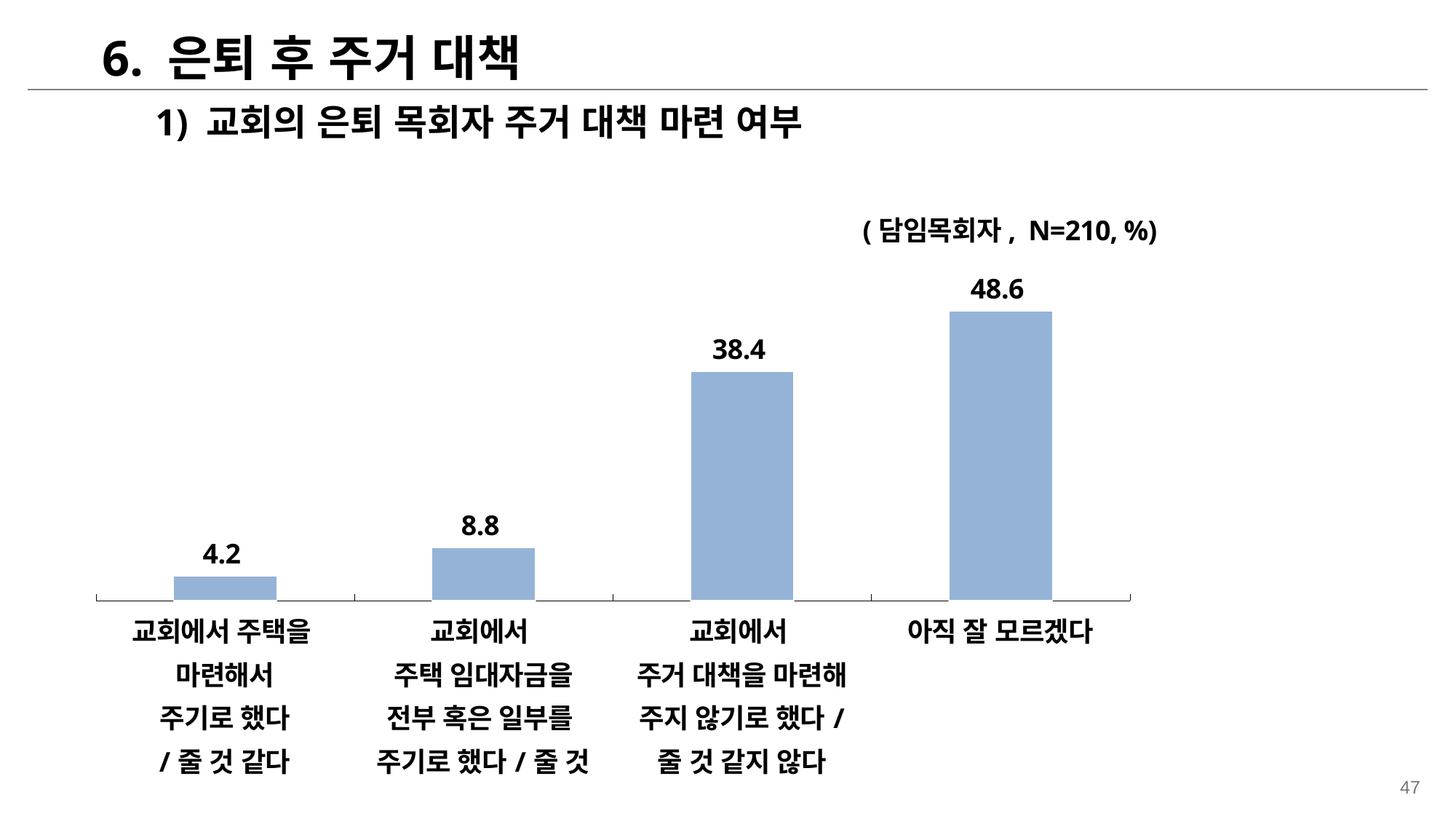
Which category has the lowest value? 교회에서 주택을 마련해서 주기로 했다 / 줄 것 같다 What is the value for '교회에서 주거 대책을 마련해 주지 않기로 했다 / 줄 것 같지 않다'? 38.4 What is the value for '교회에서 주택을 마련해서 주기로 했다 / 줄 것 같다'? 4.2 What kind of chart is shown on the slide? Bar chart Which is larger: the value for '교회에서 주거 대책을 마련해 주지 않기로 했다 / 줄 것 같지 않다' or the value for '교회에서 주택 임대자금을 전부 혹은 일부를 주기로 했다 / 줄 것'? 교회에서 주거 대책을 마련해 주지 않기로 했다 / 줄 것 같지 않다 What is the difference between the values for '교회에서 주택 임대자금을 전부 혹은 일부를 주기로 했다 / 줄 것' and '교회에서 주택을 마련해서 주기로 했다 / 줄 것 같다'? 4.6 What is the value for '아직 잘 모르겠다'? 48.6 Which category has the highest value? 아직 잘 모르겠다 What is the sample size (N) stated for the chart? N=210 What is the value for '교회에서 주택 임대자금을 전부 혹은 일부를 주기로 했다 / 줄 것'? 8.8 What is the difference between the values for '아직 잘 모르겠다' and '교회에서 주거 대책을 마련해 주지 않기로 했다 / 줄 것 같지 않다'? 10.2 How many categories are shown in the chart? 4